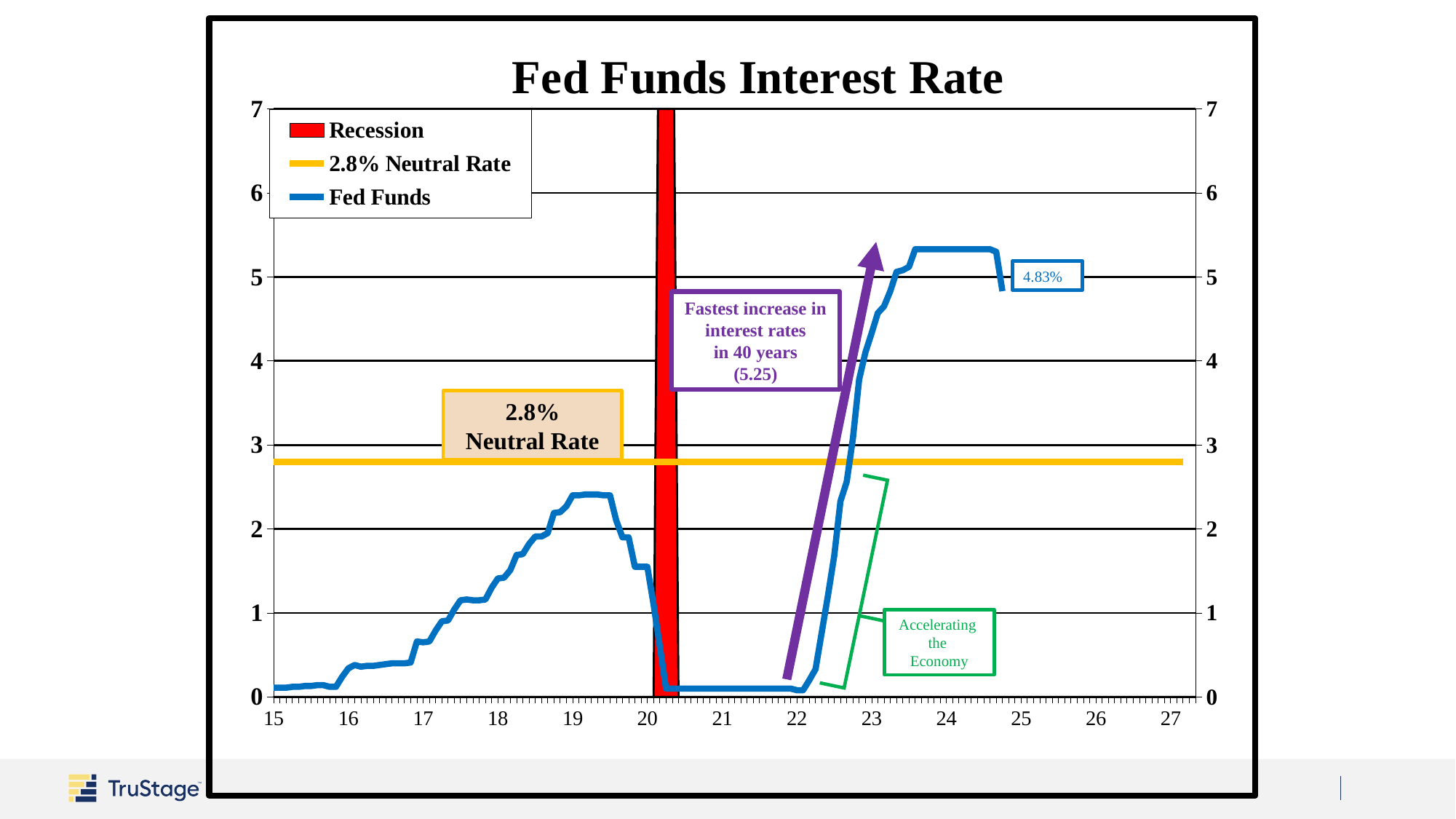
What is the title of the chart? Fed Funds Interest Rate What value is given in the annotation about the fastest increase in interest rates in 40 years? 5.25 Does the Fed Funds line rise or fall between 22 and 23? rise Is the Fed Funds value at 24 greater or less than 5? greater Is the Fed Funds value at 17 greater or less than 1? less Which is larger, the Fed Funds value at 19 or the Fed Funds value at 24? 24 What is the value of the neutral rate shown on the chart? 2.8% Is the Fed Funds value at 21 greater or less than 1? less Does the Fed Funds line rise or fall between 19.5 and 20.5? fall What kind of chart is shown on the slide? line chart How many entries does the chart's legend list? 3 What is the labelled value at the end of the Fed Funds line? 4.83%